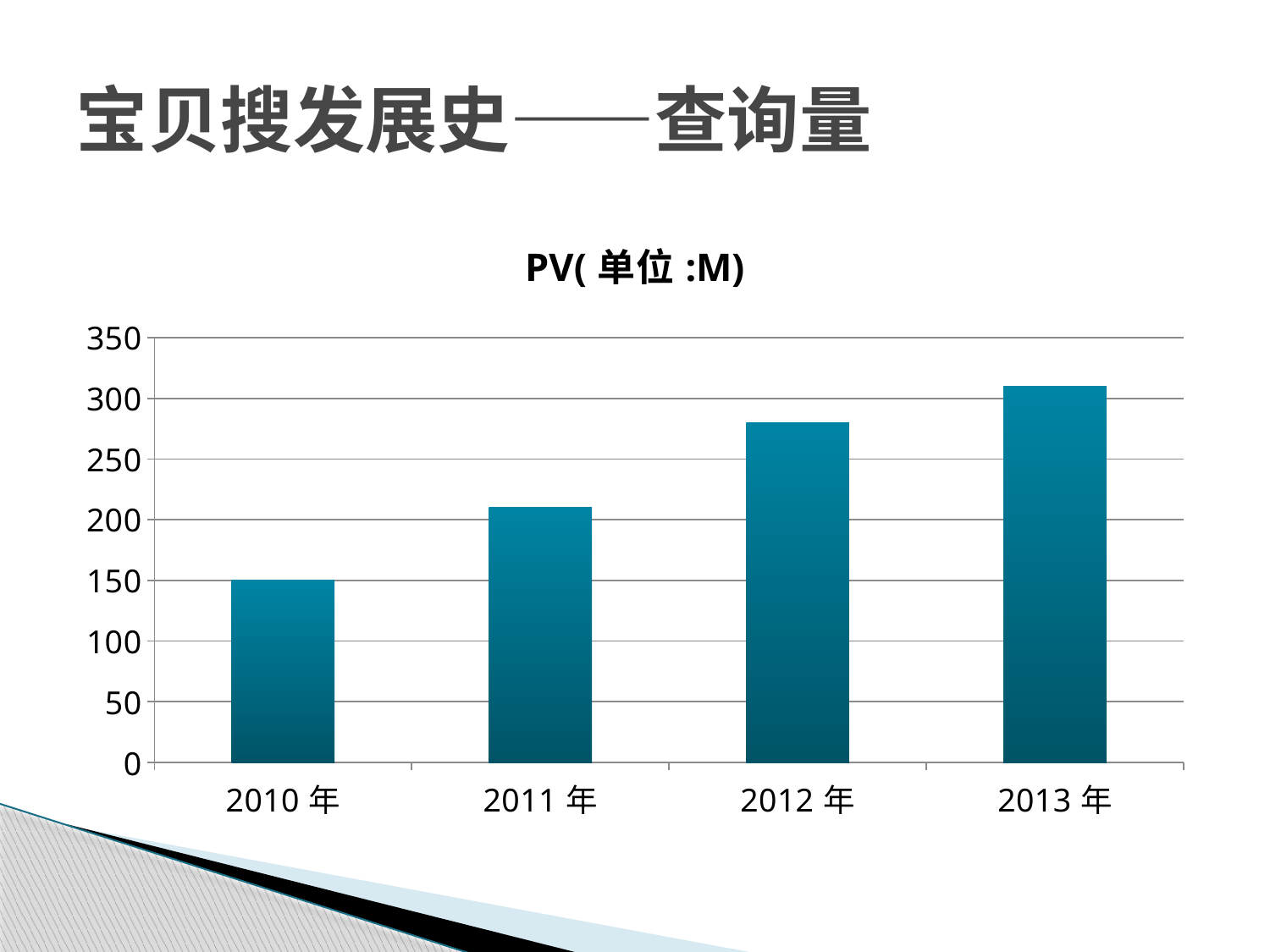
What is the PV value for 2010 年? 150 Is the PV value for 2012 年 greater or less than 300? less Which year has a larger PV value, 2011 年 or 2012 年? 2012 年 Is the PV value for 2013 年 greater or less than 300? greater What kind of chart is shown on the slide? bar chart Do the PV values rise or fall from 2010 年 to 2013 年? rise What is the highest value shown on the vertical axis of the chart? 350 Is the PV value for 2011 年 greater or less than 200? greater Which year has the lowest PV value? 2010 年 How many years are shown on the x axis of the chart? 4 What is the title of the chart? PV( 单位 :M) Which year has the highest PV value? 2013 年